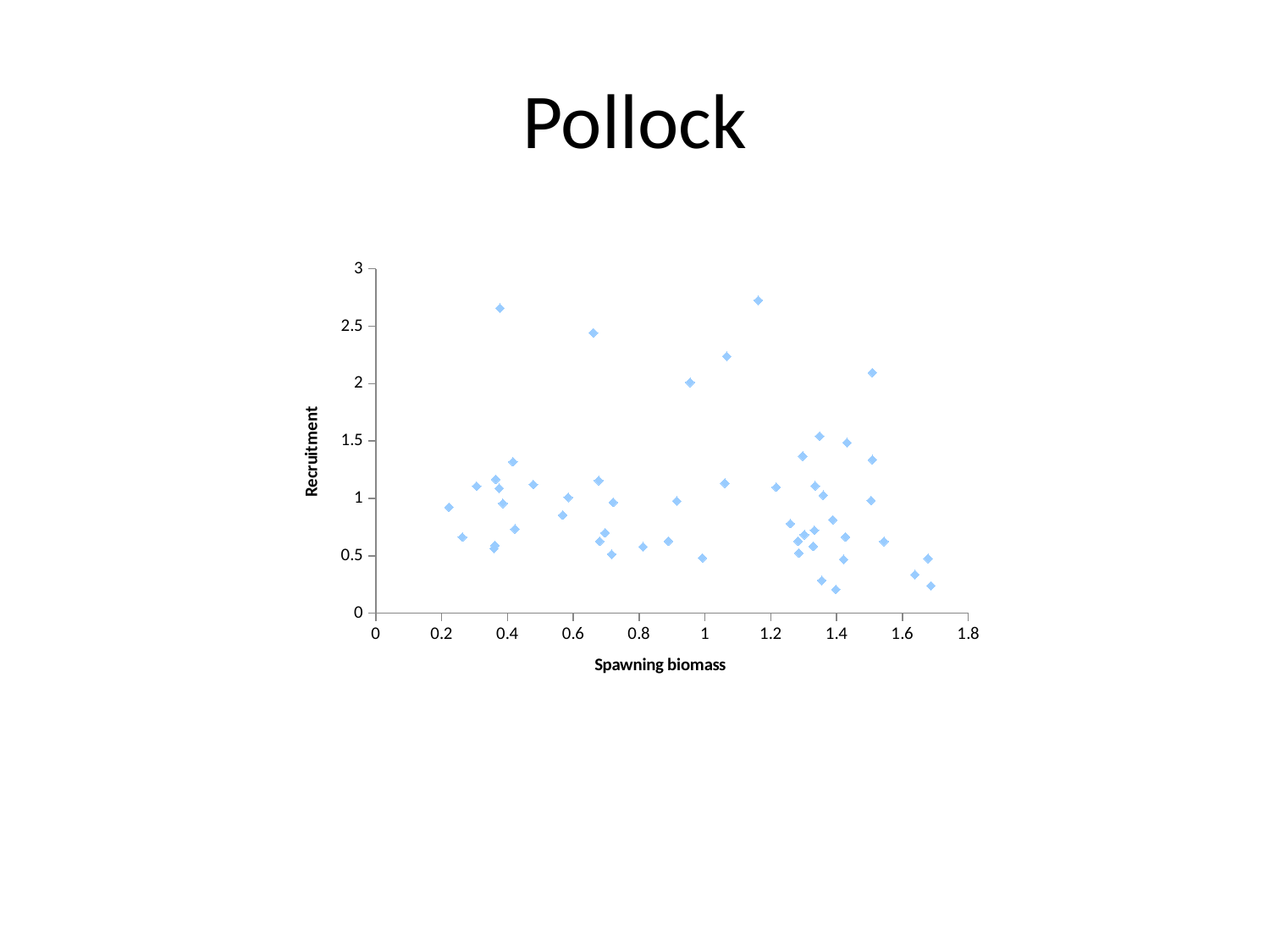
What is the title of the chart? Pollock Is the highest Recruitment value plotted greater or less than 2.5? greater What is the label on the vertical axis of the chart? Recruitment Does any point have a Recruitment value greater than 3? No What is the highest tick value shown on the Recruitment axis? 3 Is the largest Spawning biomass value plotted greater or less than 1.6? greater What is the highest tick value shown on the Spawning biomass axis? 1.8 What kind of chart is shown on the slide? scatter chart